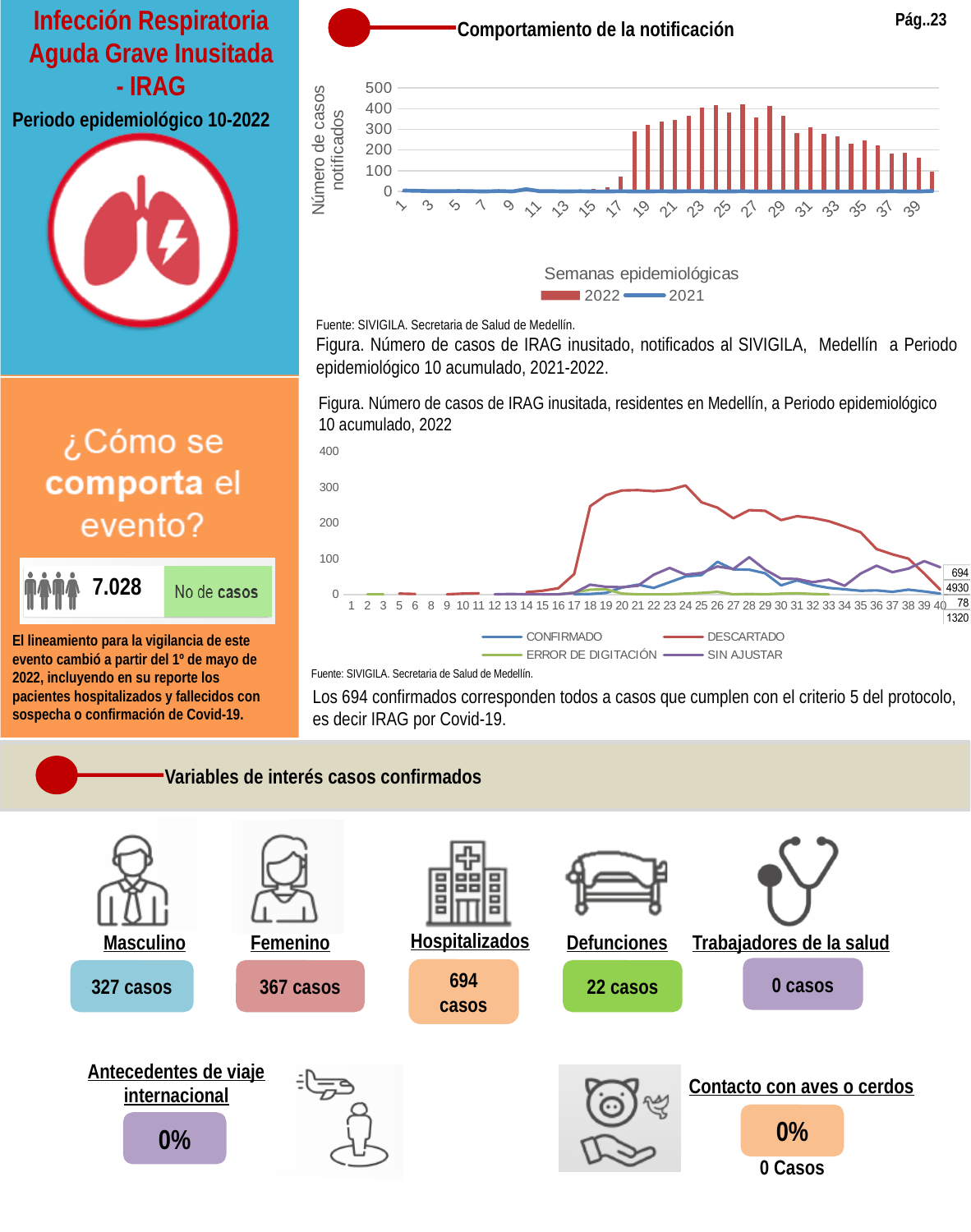
In the bottom chart (casos de IRAG inusitada, residentes en Medellín), which series reaches the highest peak? DESCARTADO In the top chart 'Comportamiento de la notificación', how many series does the legend list? 2 In the bottom chart (casos de IRAG inusitada, residentes en Medellín), is the DESCARTADO value at week 20 greater or less than 200? greater In the top chart 'Comportamiento de la notificación', what kind of chart is used to plot the 2022 series? bar chart In the top chart 'Comportamiento de la notificación', is the 2022 value for week 17 greater or less than 100? less In the top chart 'Comportamiento de la notificación', do the 2022 values rise or fall from week 28 to week 40? fall In the top chart 'Comportamiento de la notificación', is the 2022 value for week 30 greater or less than 300? less In the bottom chart (casos de IRAG inusitada, residentes en Medellín), how many series does the legend list? 4 In the top chart 'Comportamiento de la notificación', which is larger at week 25: the 2022 value or the 2021 value? 2022 In the bottom chart (casos de IRAG inusitada, residentes en Medellín), what kind of chart is it? line chart In the top chart 'Comportamiento de la notificación', what is the label of the x axis? Semanas epidemiológicas